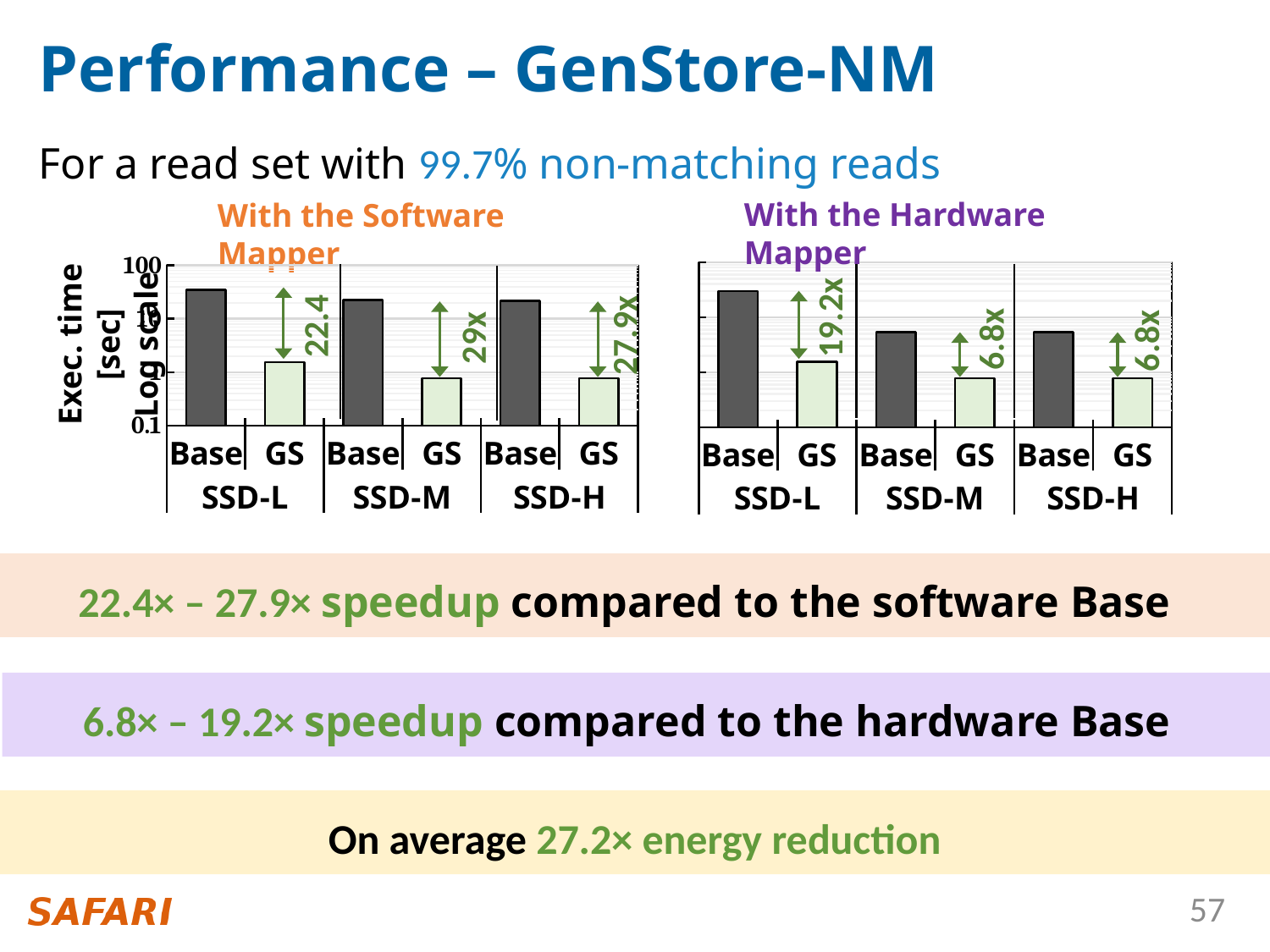
In the 'With the Hardware Mapper' chart, what speedup is annotated for SSD-L? 19.2x How many SSD configurations are shown on the x axis of the 'With the Software Mapper' chart? 3 What kind of chart is the 'With the Software Mapper' chart? bar chart In the 'With the Software Mapper' chart, which SSD configuration has the largest annotated speedup? SSD-M In the 'With the Hardware Mapper' chart, is the Base bar for SSD-M greater or less than 10? less In the 'With the Hardware Mapper' chart, which bar is taller for SSD-L, Base or GS? Base In the 'With the Hardware Mapper' chart, what speedup is annotated for SSD-M? 6.8x In the 'With the Software Mapper' chart, what speedup is annotated for SSD-M? 29x What is the y-axis label of the charts? Exec. time [sec] Log scale In the 'With the Software Mapper' chart, is the GS bar for SSD-M greater or less than 1? less In the 'With the Software Mapper' chart, is the Base bar for SSD-L greater or less than 10? greater In the 'With the Software Mapper' chart, what speedup is annotated for SSD-H? 27.9x